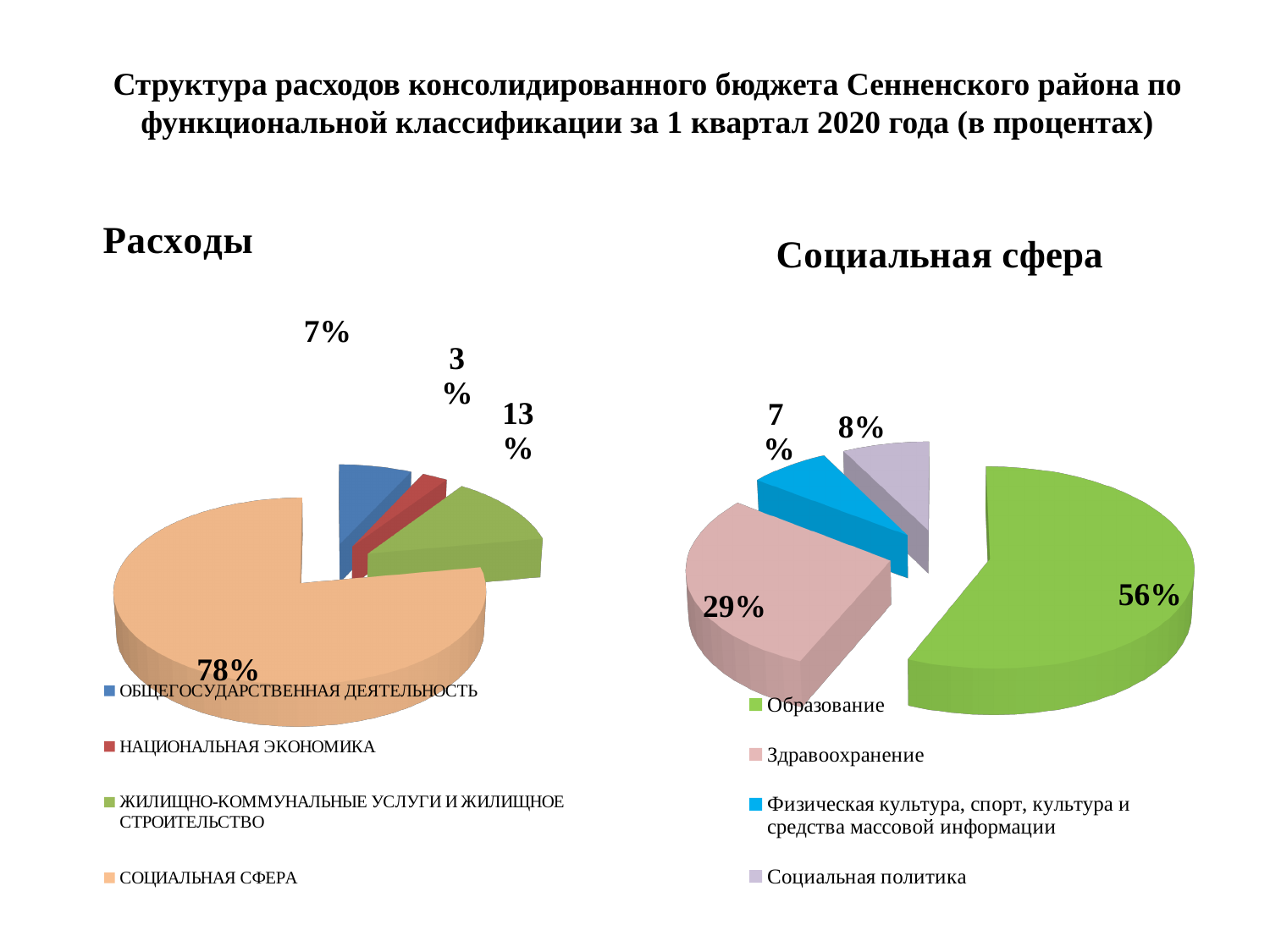
In the "Социальная сфера" chart, what is the difference in percentage points between Образование and Здравоохранение? 27 In the "Расходы" chart, which category has the smallest share? НАЦИОНАЛЬНАЯ ЭКОНОМИКА What type of chart is the "Социальная сфера" chart? Pie chart In the "Социальная сфера" chart, which is larger, Здравоохранение or Социальная политика? Здравоохранение In the "Социальная сфера" chart, what share is Социальная политика? 8% In the "Расходы" chart, how many categories are shown? 4 In the "Расходы" chart, what share is ЖИЛИЩНО-КОММУНАЛЬНЫЕ УСЛУГИ И ЖИЛИЩНОЕ СТРОИТЕЛЬСТВО? 13% In the "Расходы" chart, which category has the largest share? СОЦИАЛЬНАЯ СФЕРА In the "Социальная сфера" chart, what share is Здравоохранение? 29%